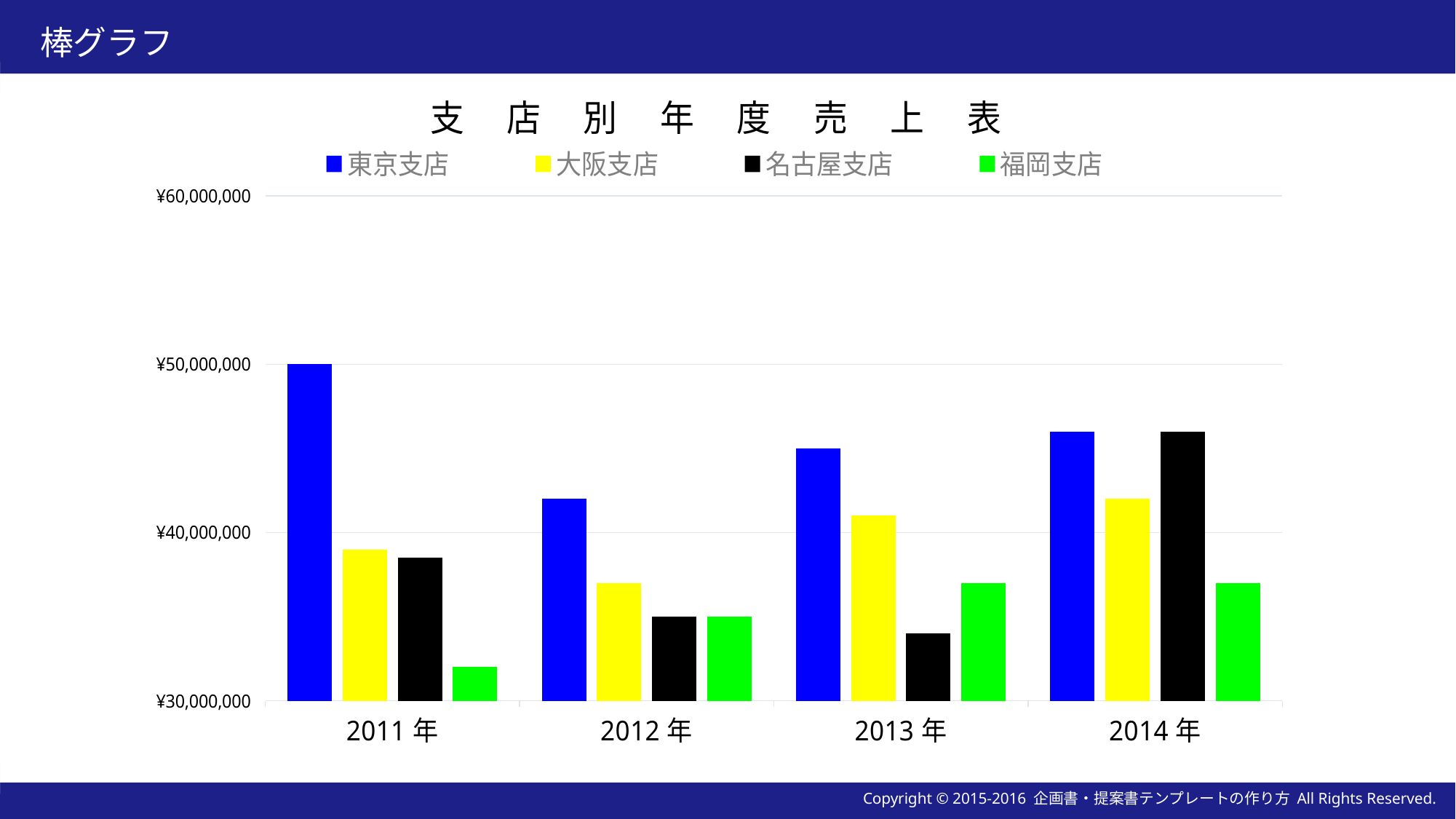
Which branch has the highest bar in 2011年? 東京支店 What kind of chart is shown on the slide? bar chart What is the value for 東京支店 in 2011年? ¥50,000,000 What is the title of the chart? 支店別年度売上表 Is the value for 東京支店 in 2012年 greater or less than ¥40,000,000? greater How many years are shown on the x axis? 4 Is the value for 名古屋支店 in 2013年 greater or less than ¥40,000,000? less Which colour represents 大阪支店 in the legend? yellow Is the value for 東京支店 in 2014年 greater or less than ¥50,000,000? less In 2014年, which is larger: 名古屋支店 or 福岡支店? 名古屋支店 Which branch has the lowest bar in 2011年? 福岡支店 How many series does the legend list? 4